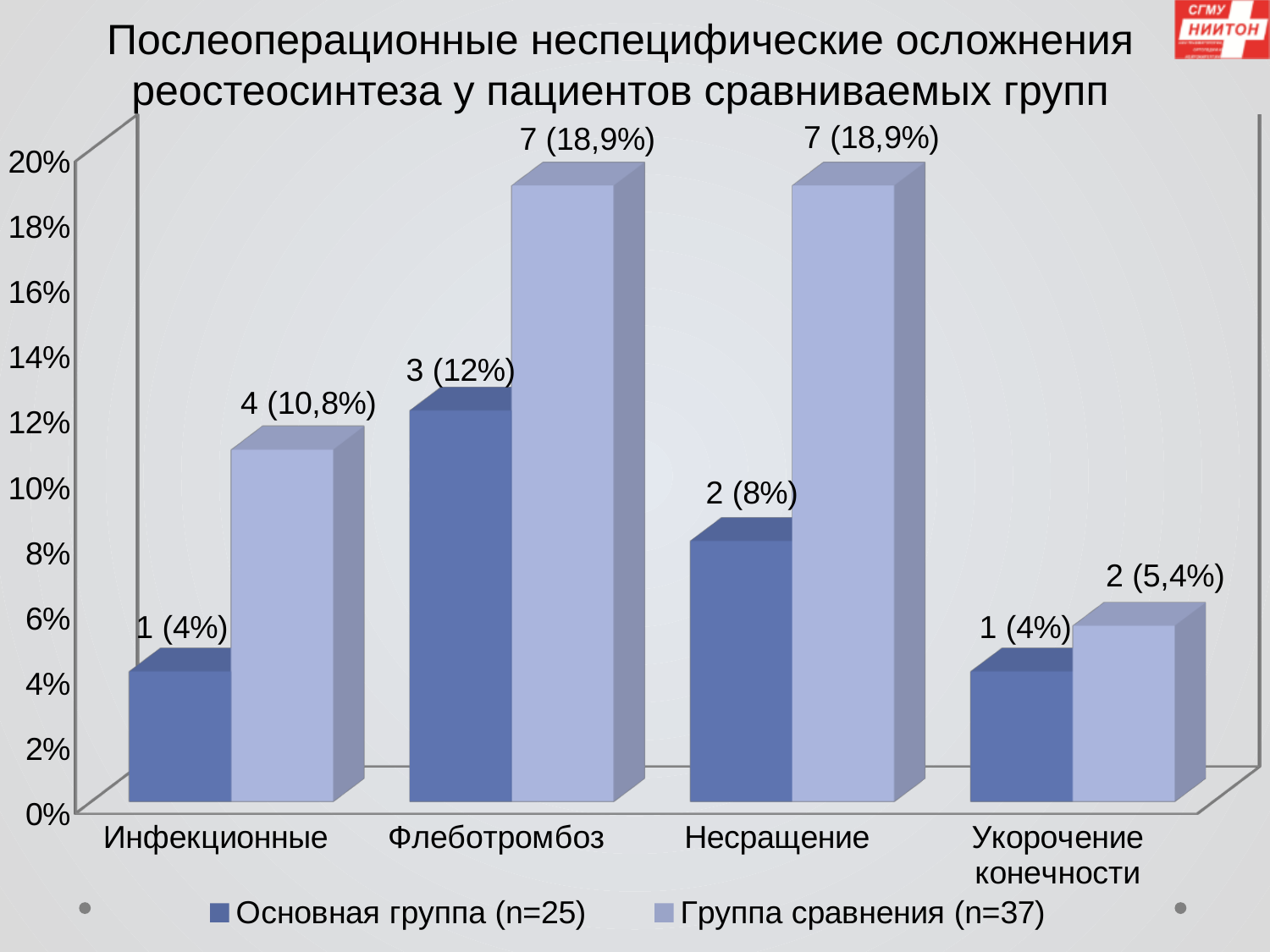
What is the data label for Укорочение конечности in the Группа сравнения (n=37) series? 2 (5,4%) What is the difference in percentage between the Группа сравнения (n=37) and Основная группа (n=25) values for Несращение? 10,9% How many categories are shown on the x axis? 4 What is the data label for Инфекционные in the Основная группа (n=25) series? 1 (4%) What is the maximum value shown on the vertical axis? 20% How many series does the legend list? 2 Which category has the lowest value in the Группа сравнения (n=37) series? Укорочение конечности What kind of chart is shown on the slide? Bar chart Which category has the highest value in the Основная группа (n=25) series? Флеботромбоз What is the data label for Несращение in the Основная группа (n=25) series? 2 (8%) What is the data label for Флеботромбоз in the Группа сравнения (n=37) series? 7 (18,9%) For Инфекционные, which series has the larger value: Основная группа (n=25) or Группа сравнения (n=37)? Группа сравнения (n=37)